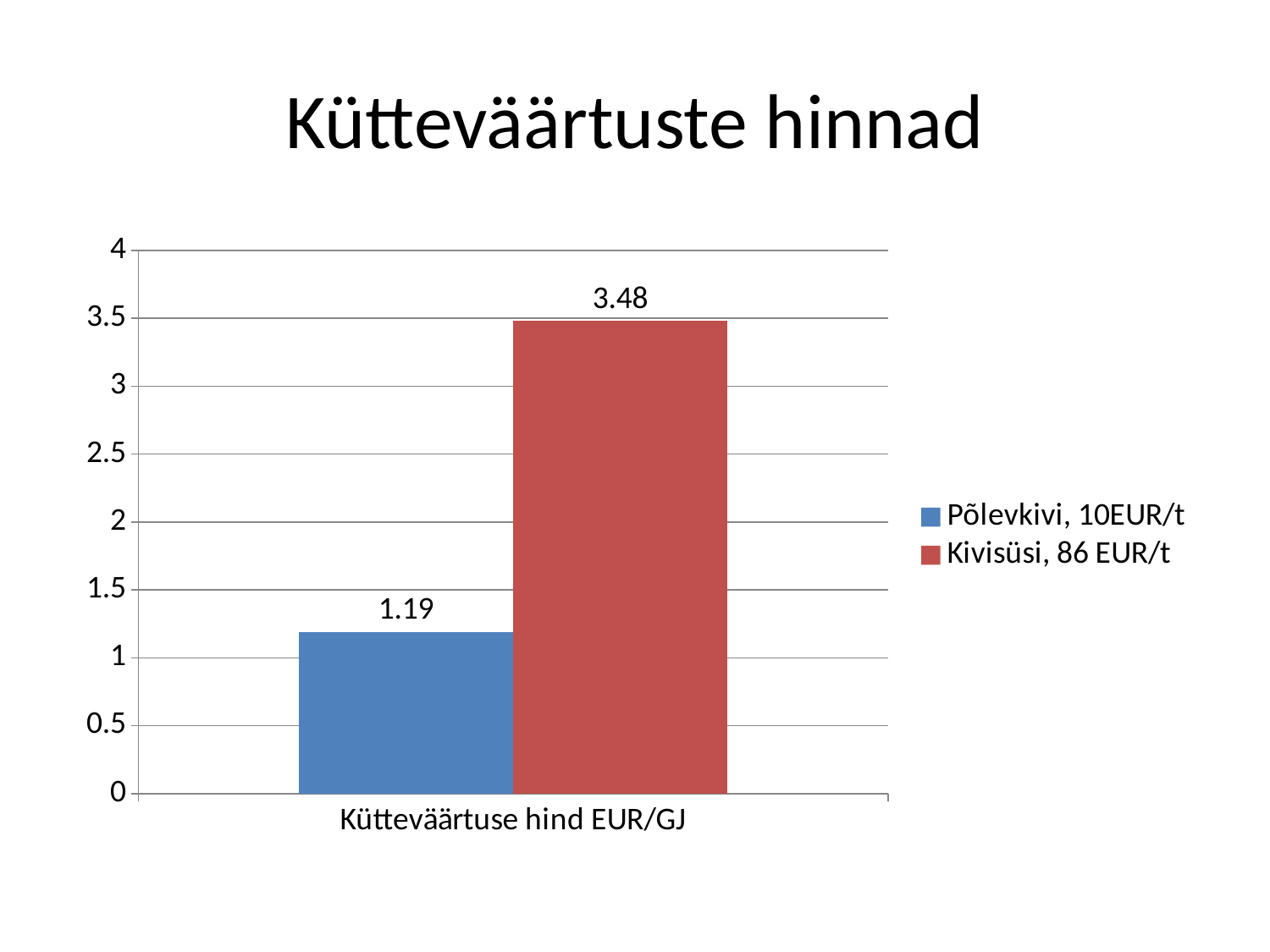
Which series has the higher value? Kivisüsi, 86 EUR/t Is the value for Põlevkivi, 10EUR/t greater or less than 1.5? less What is the difference between the values for Kivisüsi, 86 EUR/t and Põlevkivi, 10EUR/t? 2.29 Which series has the lower value? Põlevkivi, 10EUR/t What is the value for Kivisüsi, 86 EUR/t? 3.48 What is the category label shown on the x axis? Kütteväärtuse hind EUR/GJ Is the value for Põlevkivi, 10EUR/t larger or smaller than the value for Kivisüsi, 86 EUR/t? smaller How many series does the legend list? 2 What is the title of the slide? Kütteväärtuste hinnad What is the value for Põlevkivi, 10EUR/t? 1.19 What kind of chart is shown on the slide? bar chart Is the value for Kivisüsi, 86 EUR/t greater or less than 3? greater